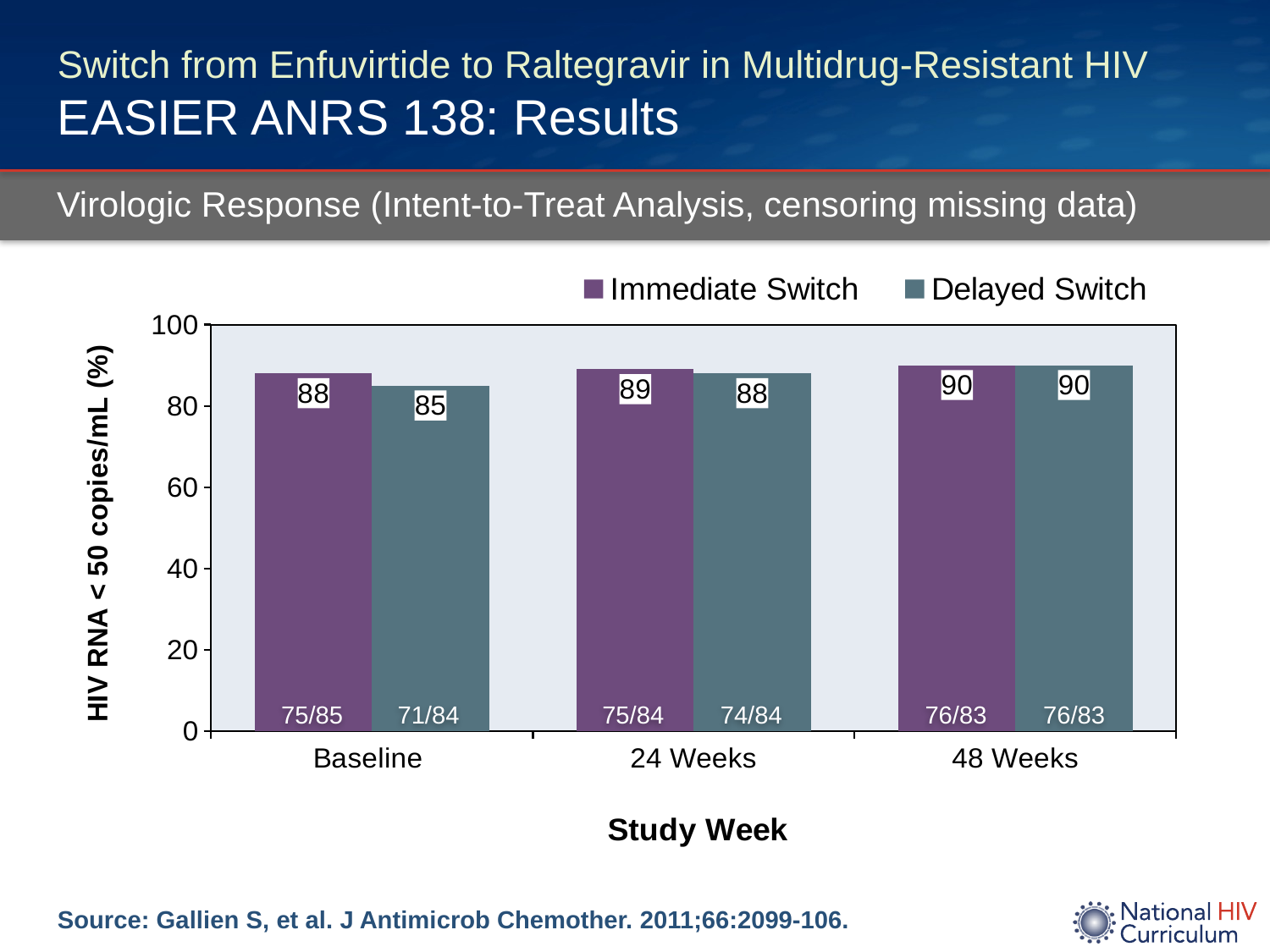
How many series does the legend list? 2 How many study week categories are shown on the x axis? 3 What kind of chart is shown? bar chart What is the value for Delayed Switch at 48 Weeks? 90 What is the difference between Immediate Switch and Delayed Switch at Baseline? 3 At which study week is the Delayed Switch value lowest? Baseline What is the value for Immediate Switch at Baseline? 88 What is the value for Immediate Switch at 24 Weeks? 89 Do the Delayed Switch values rise or fall from Baseline to 48 Weeks? rise Is the value for Immediate Switch at 48 Weeks greater or less than 80? greater What is the value for Delayed Switch at Baseline? 85 Which is larger at 24 Weeks, Immediate Switch or Delayed Switch? Immediate Switch